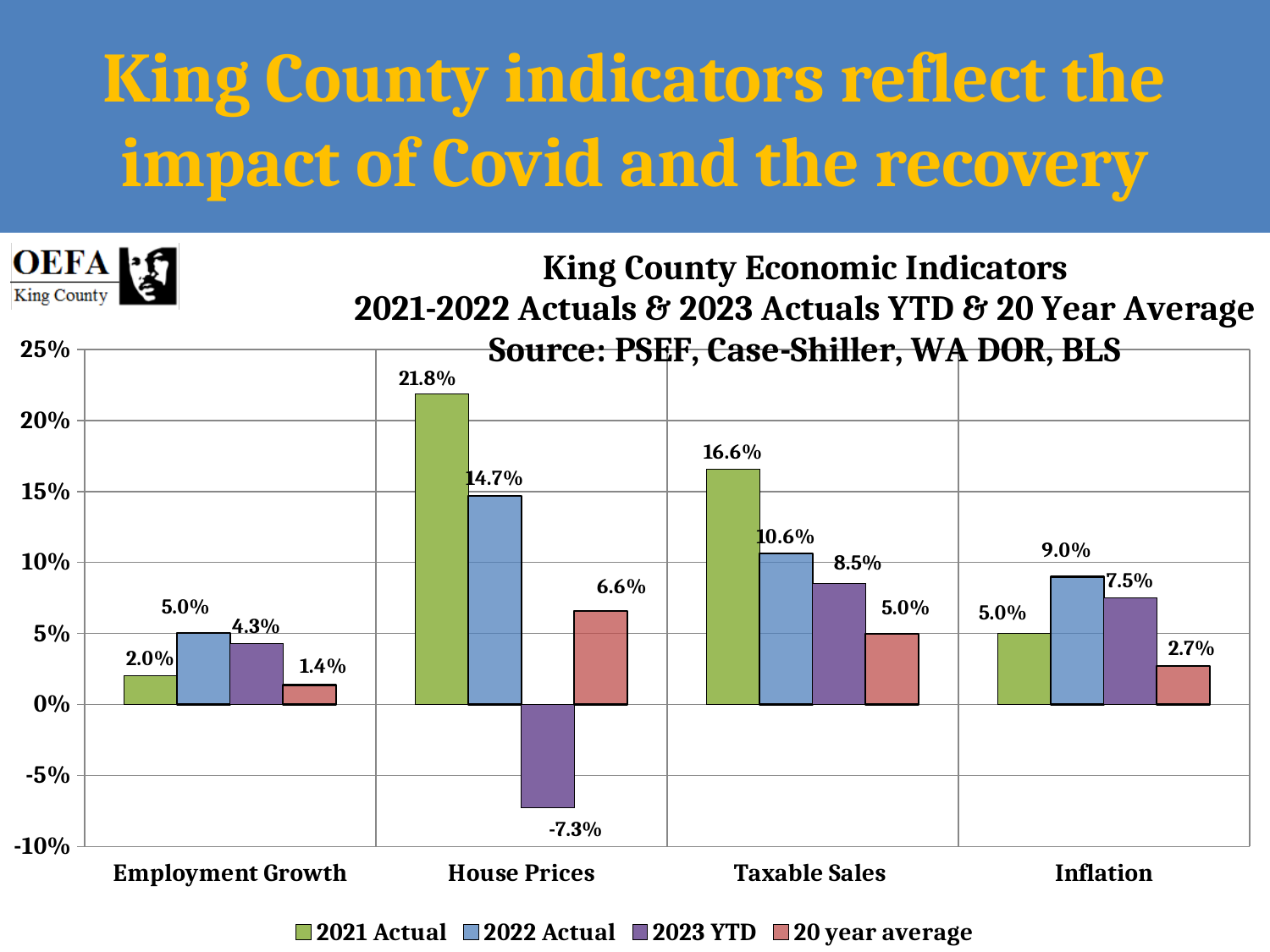
What is the 2021 Actual value for House Prices? 21.8% What is the 20 year average value for Inflation? 2.7% Which is larger for Inflation: the 2022 Actual value or the 2023 YTD value? 2022 Actual How many categories are shown on the x axis? 4 What is the difference between the 2021 Actual and 2022 Actual values for Taxable Sales? 6.0% Which series is shown in green in the legend? 2021 Actual How many series does the legend list? 4 What kind of chart is shown on the slide? Bar chart Which category has the highest 2021 Actual value? House Prices What is the 2023 YTD value for House Prices? -7.3% What is the 2022 Actual value for Taxable Sales? 10.6% Which category has the lowest 20 year average value? Employment Growth